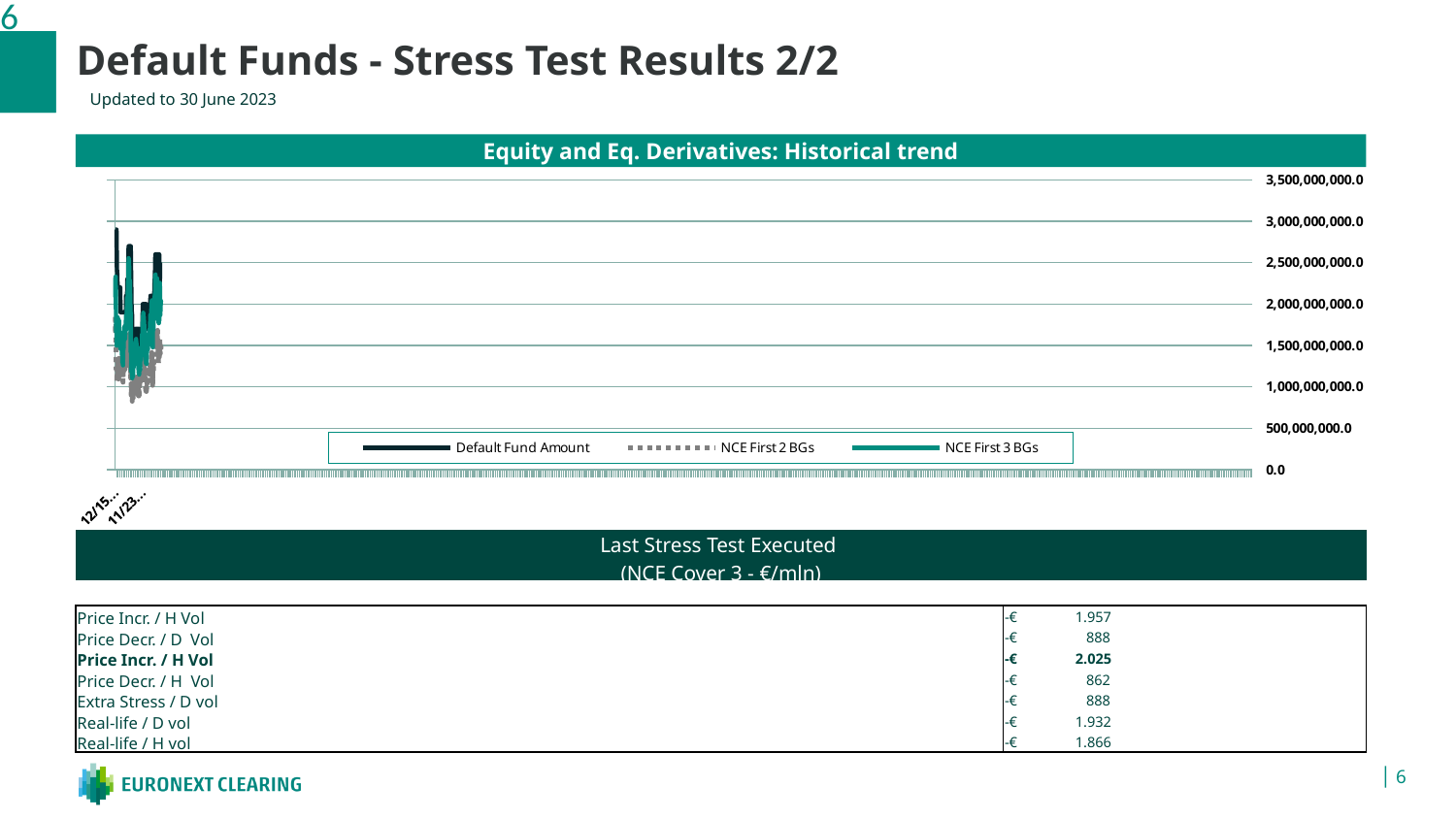
Which series are listed in the legend of the 'Equity and Eq. Derivatives: Historical trend' chart? Default Fund Amount, NCE First 2 BGs, NCE First 3 BGs How many series does the legend of the 'Equity and Eq. Derivatives: Historical trend' chart list? 3 What is the title of the chart on the slide? Equity and Eq. Derivatives: Historical trend In the 'Equity and Eq. Derivatives: Historical trend' chart, is the peak value of the Default Fund Amount series greater or less than 3,500,000,000.0? less In the 'Equity and Eq. Derivatives: Historical trend' chart, are the values of the NCE First 2 BGs series greater or less than 500,000,000.0? greater What kind of chart is shown under the heading 'Equity and Eq. Derivatives: Historical trend'? line chart In the 'Equity and Eq. Derivatives: Historical trend' chart, what is the highest value shown on the vertical axis? 3,500,000,000.0 In the 'Equity and Eq. Derivatives: Historical trend' chart, what is the lowest value shown on the vertical axis? 0.0 In the 'Equity and Eq. Derivatives: Historical trend' chart, is the peak value of the Default Fund Amount series greater or less than 2,000,000,000.0? greater